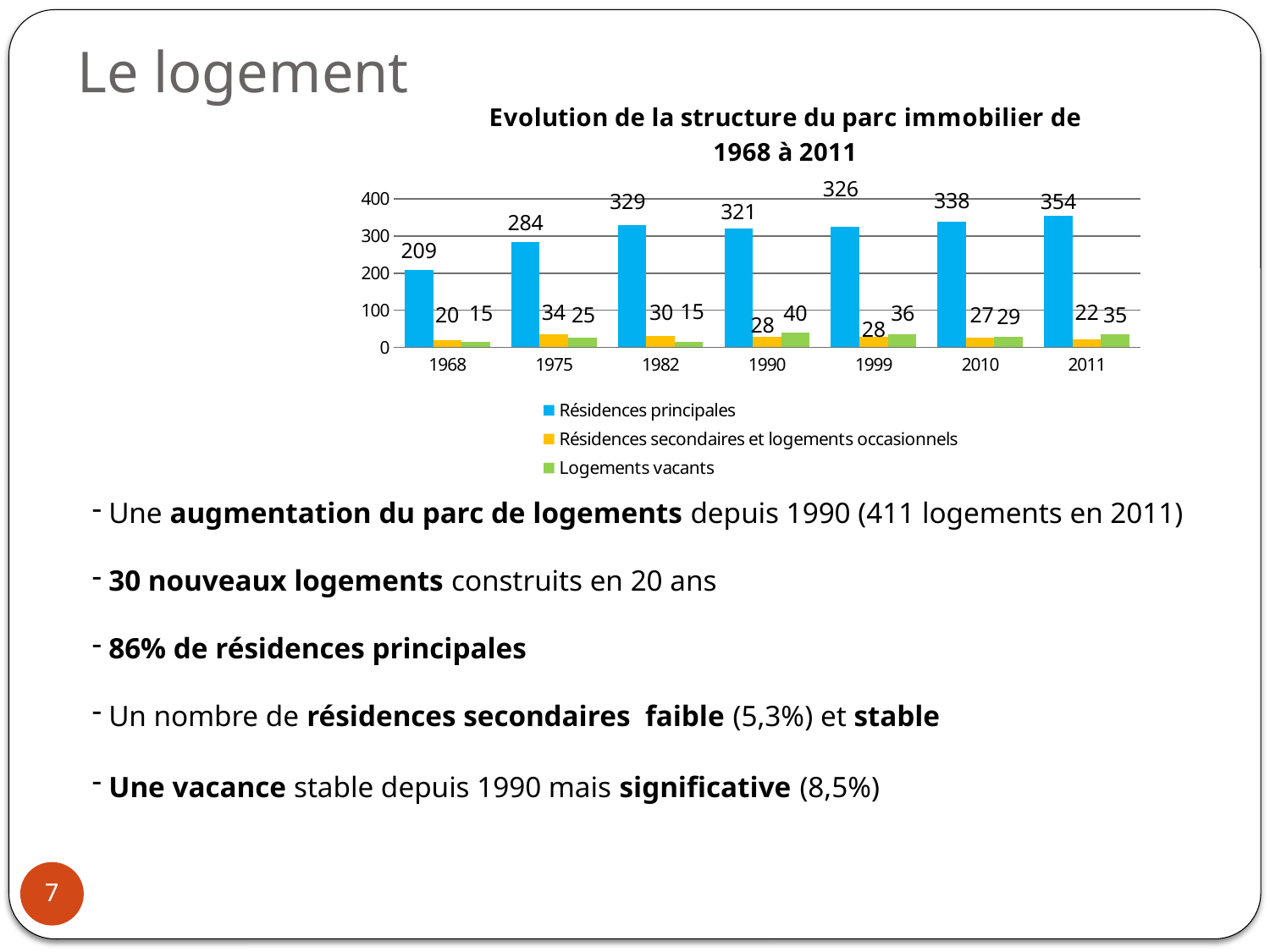
What kind of chart is shown on the slide? bar chart Is the value for Résidences principales in 1975 greater or less than 300? less In which year is the value for Résidences principales highest? 2011 What is the value for Résidences principales in 1968? 209 What is the value for Logements vacants in 1990? 40 In which year is the value for Résidences principales lowest? 1968 How many years are shown on the x axis? 7 What is the title of the chart? Evolution de la structure du parc immobilier de 1968 à 2011 Which is larger in 1999: Résidences secondaires et logements occasionnels or Logements vacants? Logements vacants What is the value for Résidences secondaires et logements occasionnels in 1975? 34 What is the difference between Résidences principales in 2011 and in 1968? 145 How many series does the legend list? 3